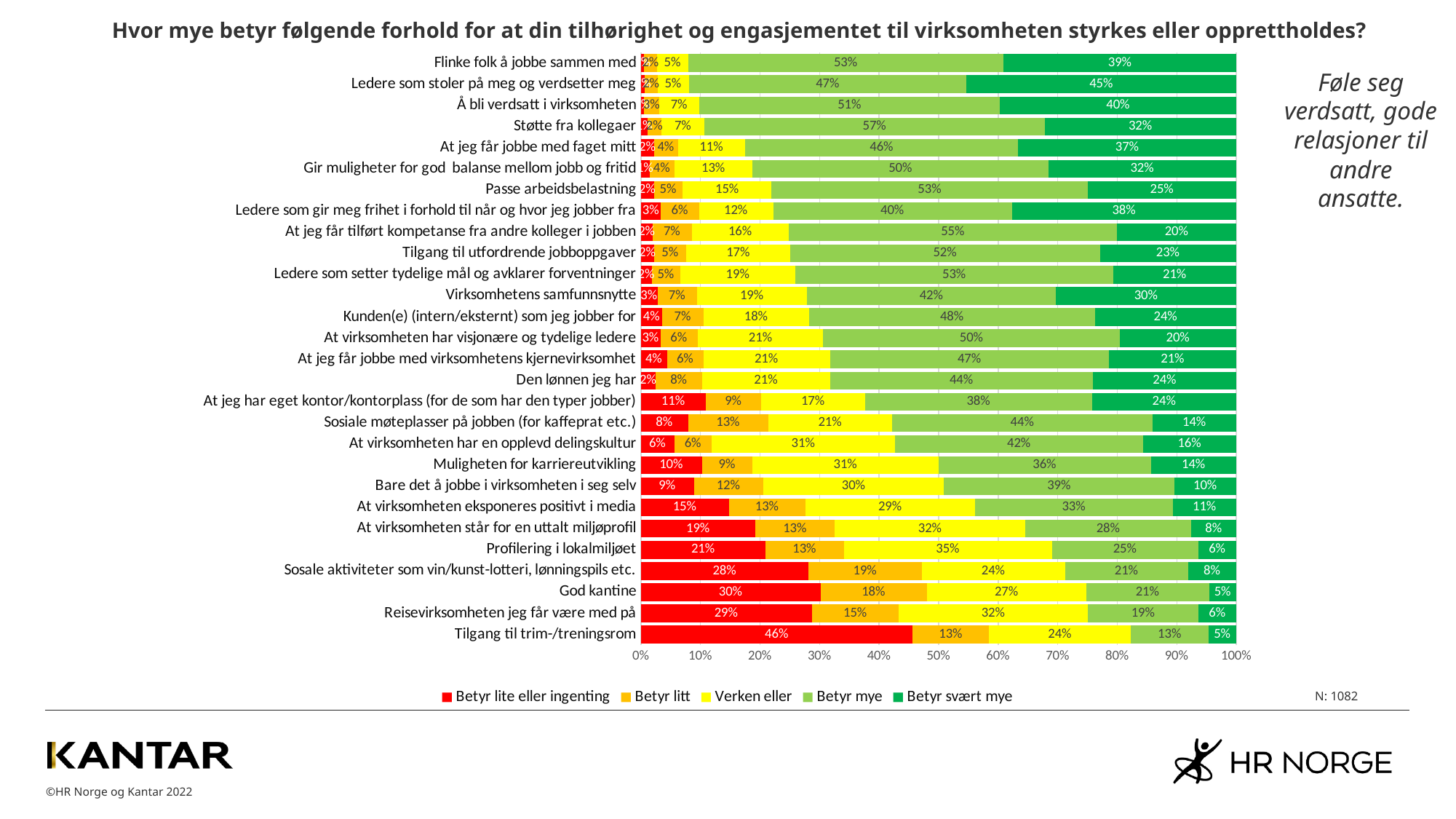
Which has a larger "Betyr svært mye" share: "Virksomhetens samfunnsnytte" or "Den lønnen jeg har"? Virksomhetens samfunnsnytte What is the "Verken eller" value for "Muligheten for karriereutvikling"? 31% Which category has the highest "Betyr svært mye" share? Ledere som stoler på meg og verdsetter meg What is the "Betyr litt" value for "God kantine"? 18% Which category has the highest "Betyr lite eller ingenting" share? Tilgang til trim-/treningsrom How many series does the legend list? 5 What percentage answered "Betyr svært mye" for "Ledere som stoler på meg og verdsetter meg"? 45% What type of chart is shown on the slide? Stacked bar chart How many categories (rows) are shown in the chart? 28 How many percentage points higher is the "Betyr mye" value for "Støtte fra kollegaer" than for "Flinke folk å jobbe sammen med"? 4 percentage points What percentage answered "Betyr lite eller ingenting" for "Tilgang til trim-/treningsrom"? 46% Which category has the lowest "Betyr mye" share? Tilgang til trim-/treningsrom